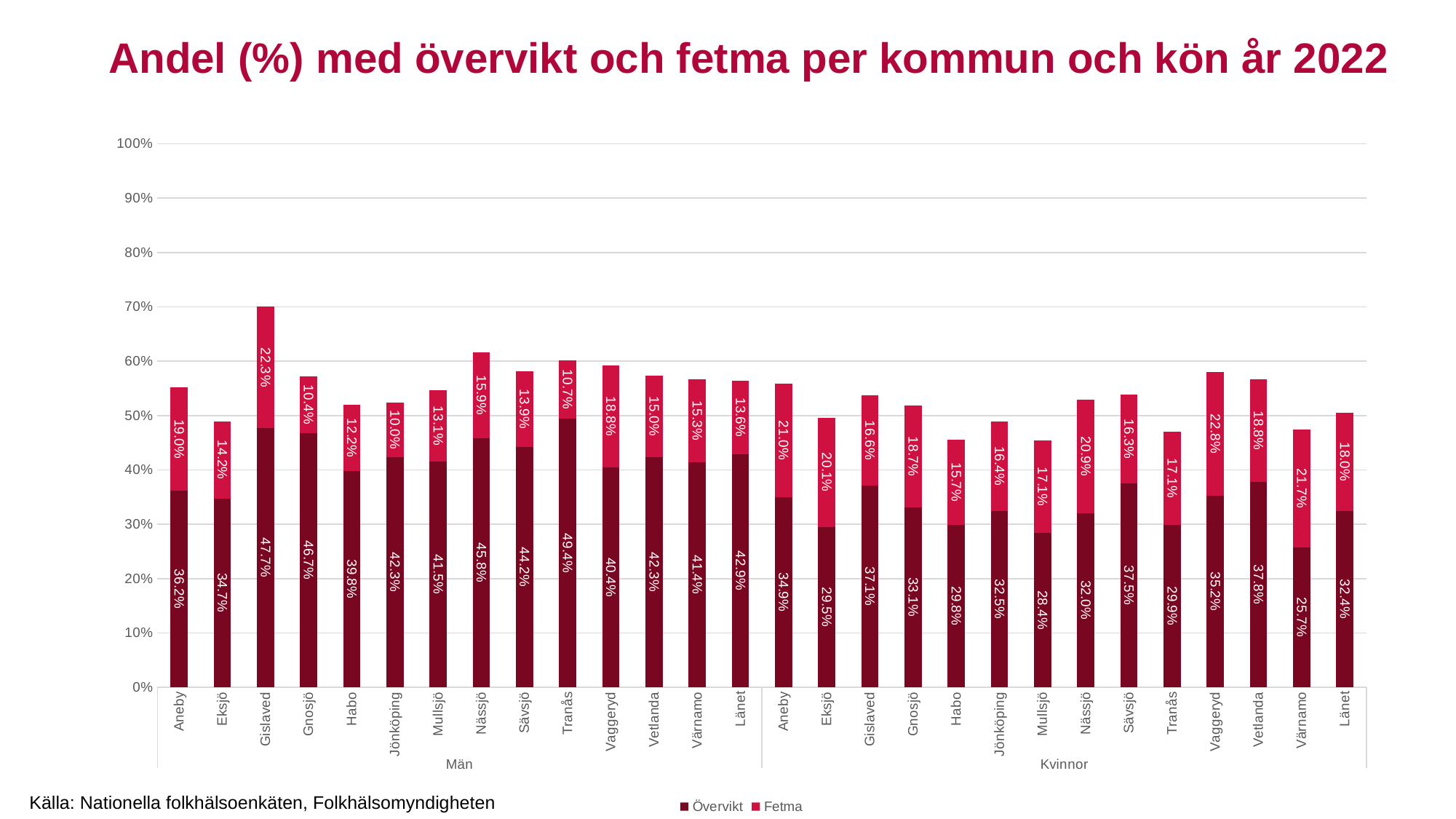
What is the difference between the Övervikt values for Aneby among Män and Aneby among Kvinnor? 1.3% What is the Övervikt value for Gislaved among Män? 47.7% Which municipality has the lowest Övervikt value among Kvinnor? Värnamo What is the Övervikt value for Länet among Kvinnor? 32.4% Which municipality has the highest Övervikt value among Män? Tranås What is the Fetma value for Värnamo among Kvinnor? 21.7% Is the total stacked bar for Mullsjö among Kvinnor greater or less than 50%? less What is the total of the stacked bar for Gislaved among Män? 70.0% Which municipality has the lowest Fetma value among Män? Jönköping What kind of chart is shown on the slide? Stacked bar chart How many series does the legend list? 2 Which is larger: the Fetma value for Vaggeryd among Kvinnor or the Fetma value for Vaggeryd among Män? Vaggeryd among Kvinnor